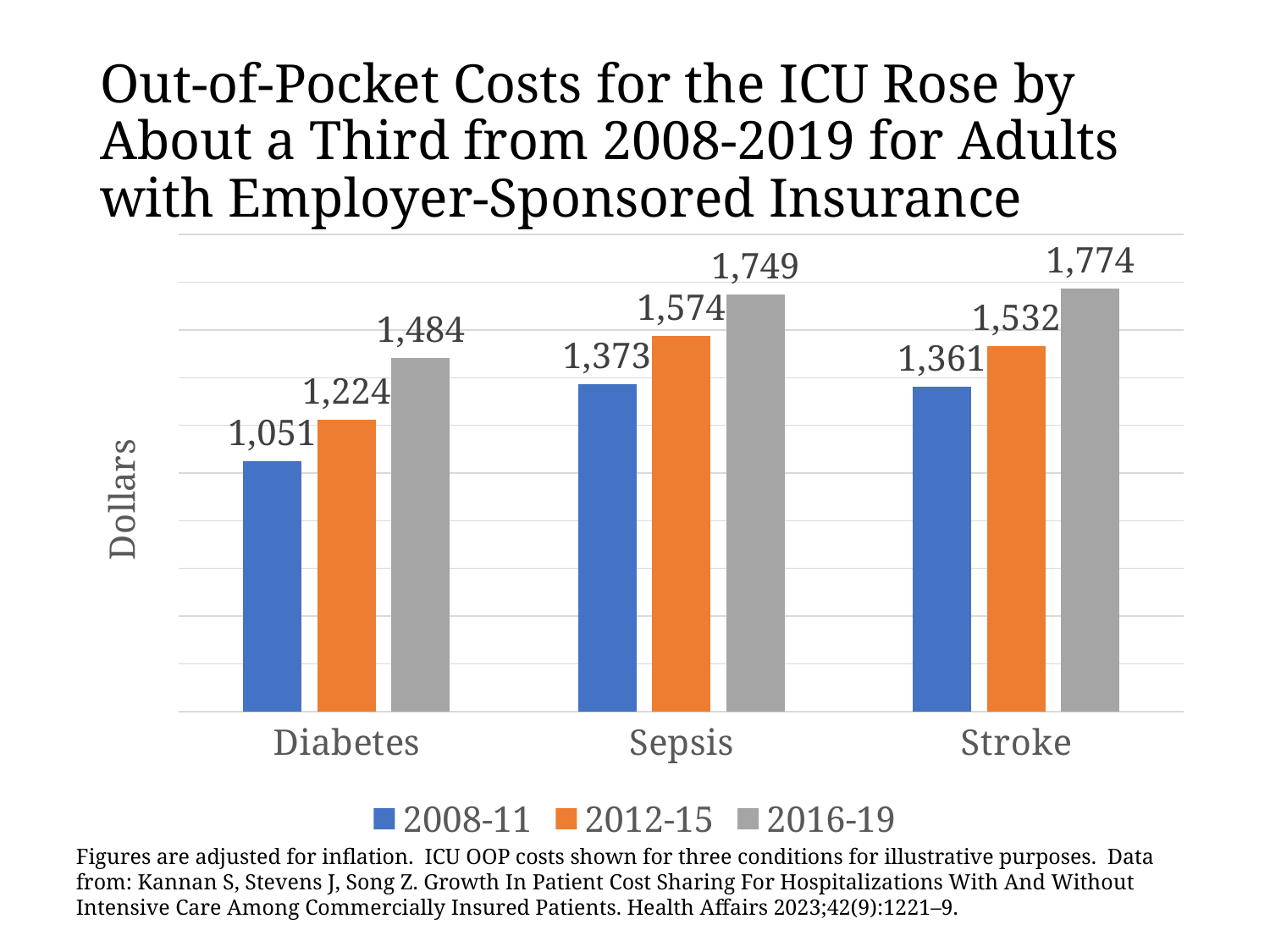
What is the label on the vertical axis? Dollars What is the out-of-pocket cost for Diabetes in 2008-11? 1,051 Which condition has the highest out-of-pocket cost in 2016-19? Stroke What is the out-of-pocket cost for Stroke in 2012-15? 1,532 What is the out-of-pocket cost for Sepsis in 2016-19? 1,749 Which is larger, the 2012-15 cost for Sepsis or the 2012-15 cost for Diabetes? Sepsis What is the difference between the Stroke and Sepsis out-of-pocket costs in 2012-15? 42 How many conditions are shown on the x axis? 3 What kind of chart is shown on the slide? Bar chart Which condition has the lowest out-of-pocket cost in 2008-11? Diabetes What is the difference between the 2016-19 and 2008-11 out-of-pocket costs for Diabetes? 433 How many series does the legend list? 3